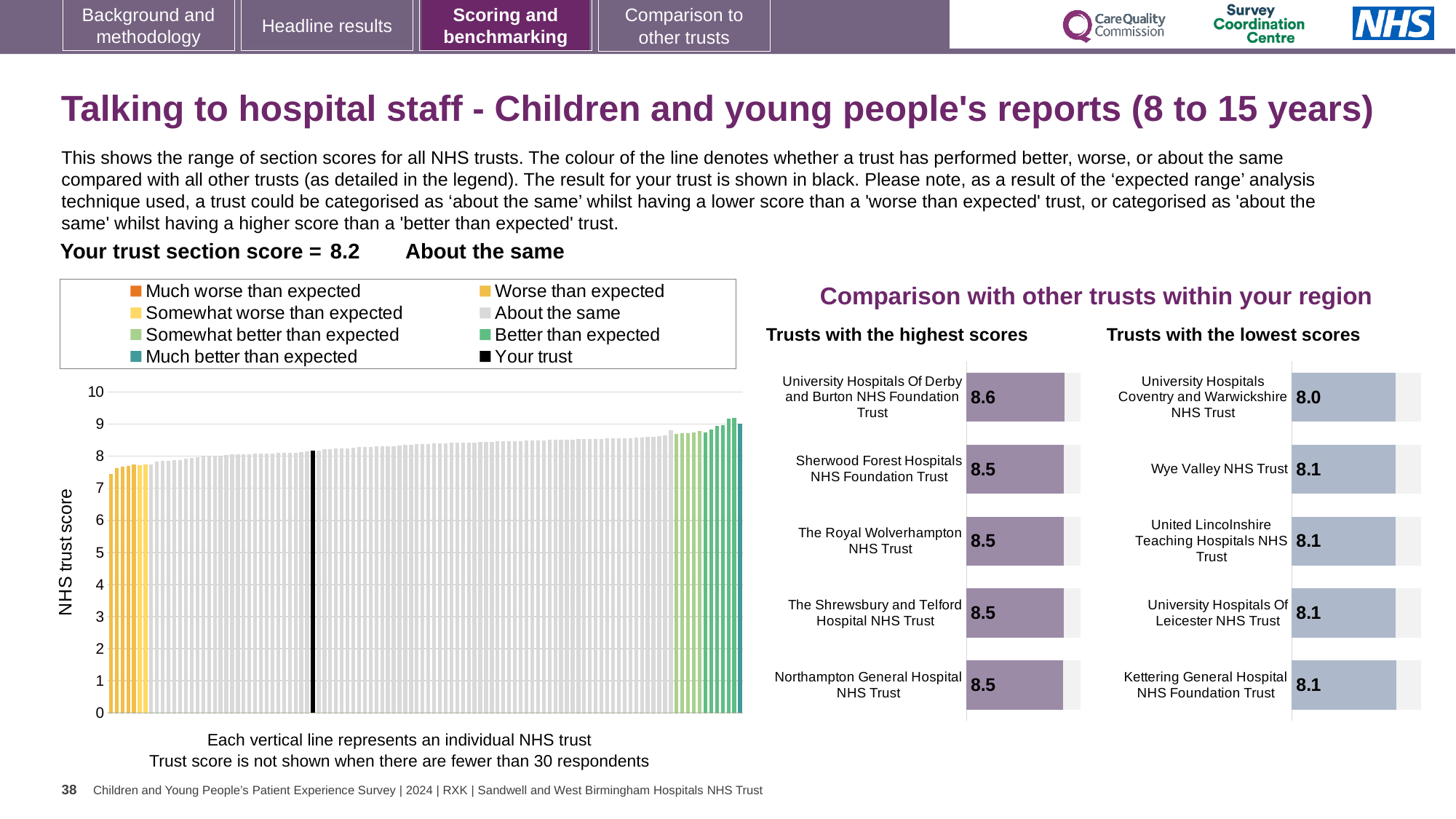
What is the difference between the score of University Hospitals Of Derby and Burton NHS Foundation Trust in the highest scores chart and Sherwood Forest Hospitals NHS Foundation Trust in the same chart? 0.1 How many entries does the legend of the main NHS trust score chart list? 8 In the 'Trusts with the highest scores' chart, what is the score for University Hospitals Of Derby and Burton NHS Foundation Trust? 8.6 Which has the larger score: Sherwood Forest Hospitals NHS Foundation Trust in the highest scores chart or Kettering General Hospital NHS Foundation Trust in the lowest scores chart? Sherwood Forest Hospitals NHS Foundation Trust What kind of chart is the main chart on the left showing NHS trust scores? Bar chart In the 'Trusts with the lowest scores' chart, what is the score for University Hospitals Coventry and Warwickshire NHS Trust? 8.0 How many trusts are shown in the 'Trusts with the highest scores' chart? 5 In the 'Trusts with the lowest scores' chart, what is the score for Wye Valley NHS Trust? 8.1 In the 'Trusts with the lowest scores' chart, which trust has the lowest score? University Hospitals Coventry and Warwickshire NHS Trust In the main NHS trust score chart, do the values rise or fall from left to right? Rise What is the label on the vertical axis of the main chart on the left? NHS trust score In the 'Trusts with the highest scores' chart, which trust has the highest score? University Hospitals Of Derby and Burton NHS Foundation Trust